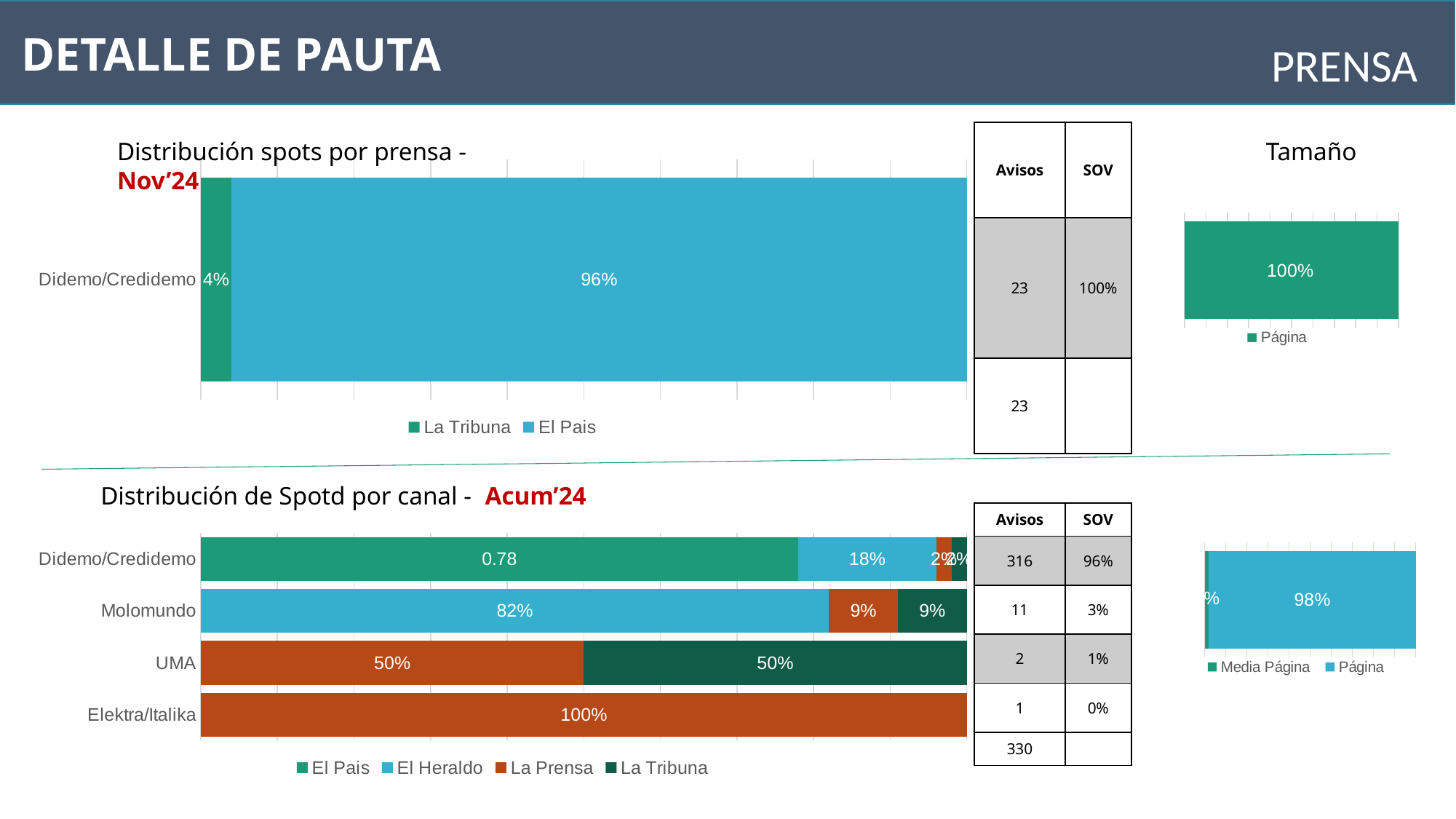
In the 'Distribución de Spotd por canal - Acum'24' chart, what is the value for El Heraldo for Molomundo? 82% In the 'Distribución spots por prensa - Nov'24' chart, how many series does the legend list? 2 In the top-right 'Tamaño' chart, what is the value for Página? 100% In the 'Distribución de Spotd por canal - Acum'24' chart, how many series does the legend list? 4 In the 'Distribución spots por prensa - Nov'24' chart, which series has the larger value, La Tribuna or El Pais? El Pais In the 'Distribución de Spotd por canal - Acum'24' chart, how many categories are shown on the y axis? 4 In the 'Distribución de Spotd por canal - Acum'24' chart, what is the value for La Prensa for Elektra/Italika? 100% What kind of chart is the 'Distribución de Spotd por canal - Acum'24' chart? Stacked bar chart In the 'Distribución spots por prensa - Nov'24' chart, what is the value for La Tribuna for Didemo/Credidemo? 4% In the 'Distribución de Spotd por canal - Acum'24' chart, what is the difference between the El Heraldo value and the La Prensa value for Molomundo? 73% In the 'Distribución de Spotd por canal - Acum'24' chart, what is the value for La Tribuna for UMA? 50% In the 'Distribución spots por prensa - Nov'24' chart, what is the value for El Pais for Didemo/Credidemo? 96%